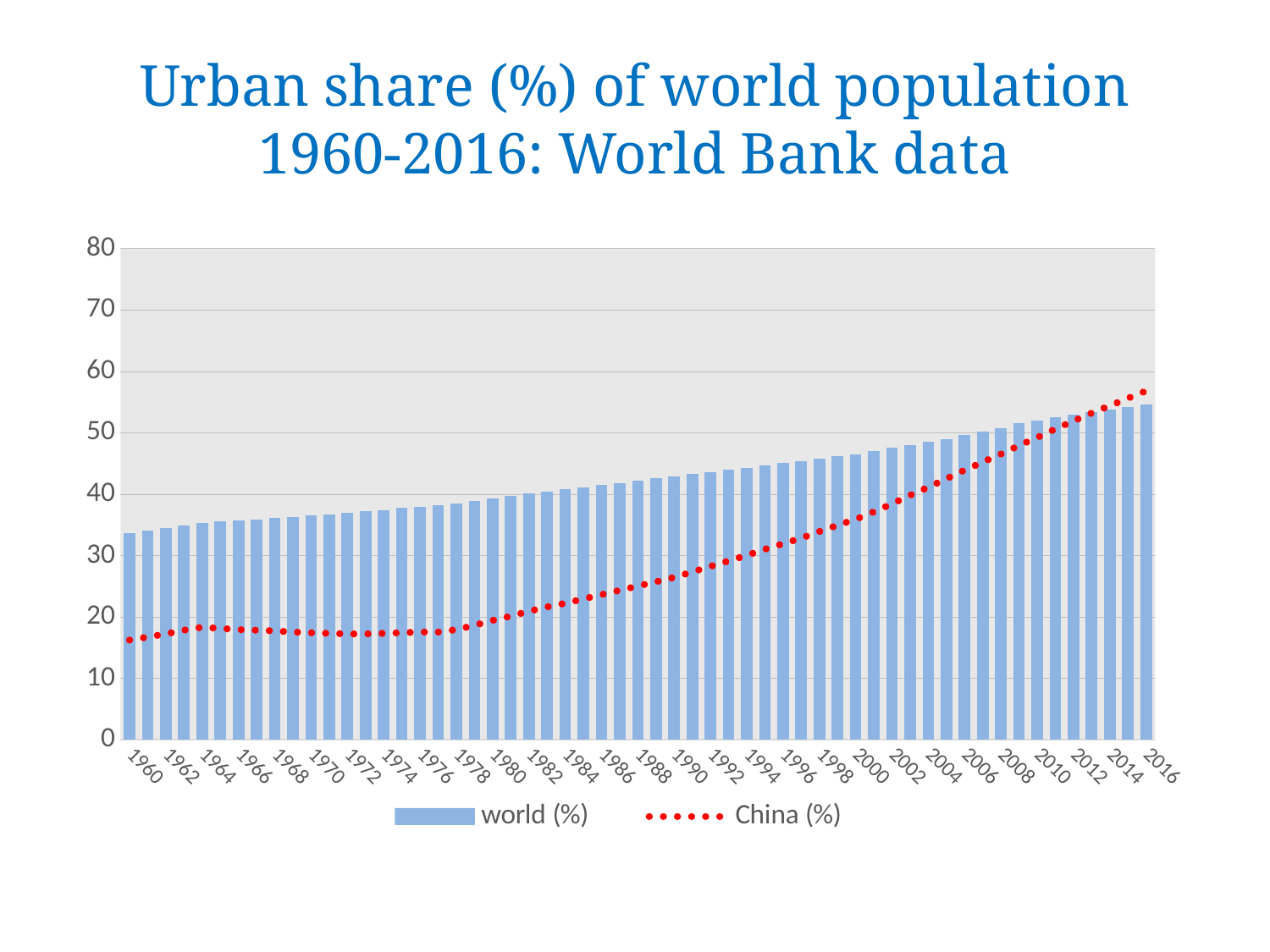
What kind of chart is shown on the slide? Bar chart with a dotted line series Do the world (%) values rise or fall from 1960 to 2016? Rise In 2000, which is larger: the world (%) value or the China (%) value? world (%) How many series does the legend list? 2 What is the title of the chart? Urban share (%) of world population 1960-2016: World Bank data What are the two series named in the legend? world (%) and China (%) Is the China (%) value for 1960 greater or less than 20? less Is the world (%) value for 1960 greater or less than 40? less In which year is the China (%) value highest? 2016 Is the China (%) value for 2016 greater or less than 50? greater In which year is the world (%) value lowest? 1960 In which year is the world (%) value highest? 2016